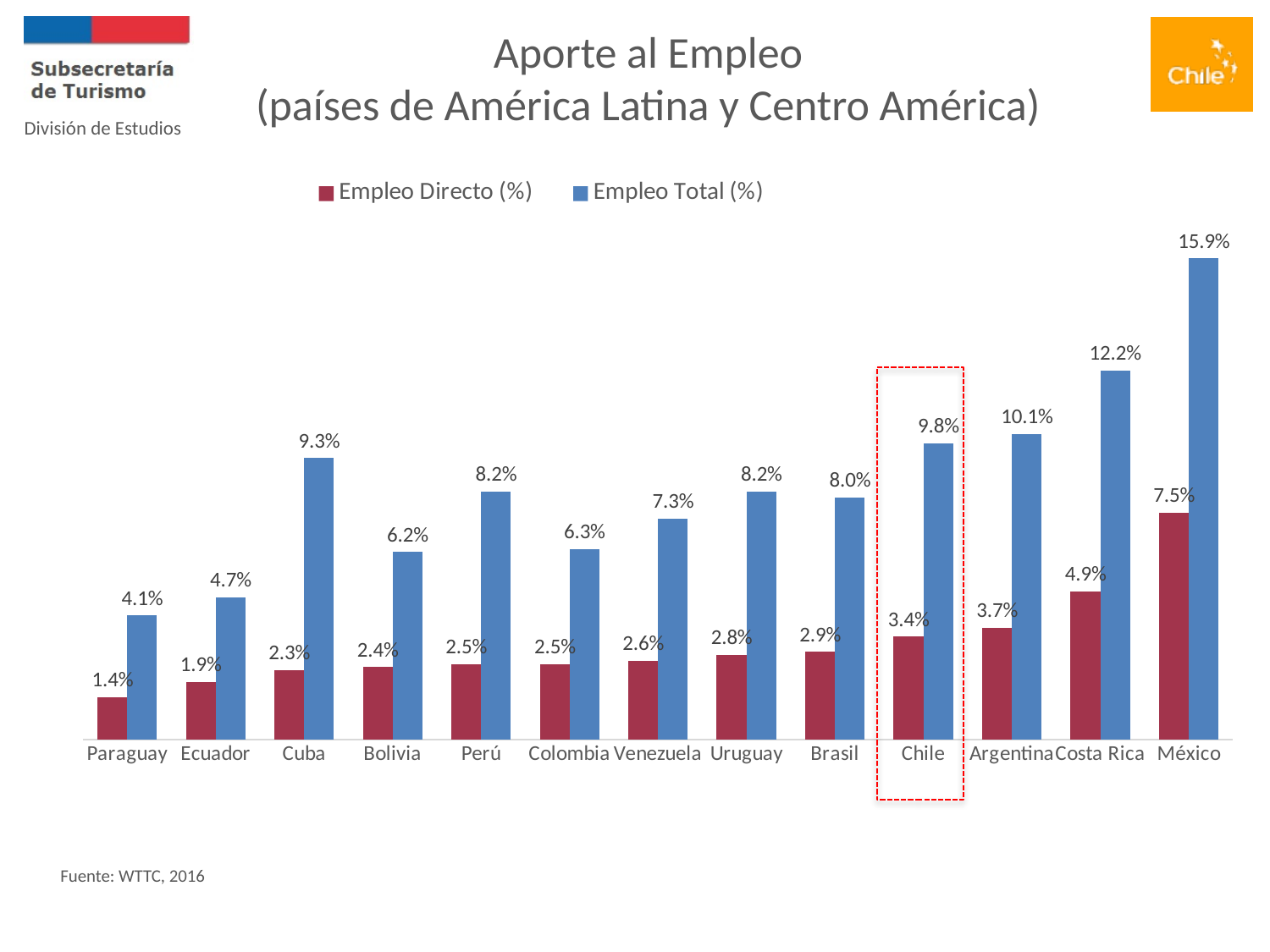
What kind of chart is shown on the slide? Bar chart What is the difference between the Empleo Total (%) and Empleo Directo (%) values for México? 8.4% Which country is highlighted with a red dashed box on the chart? Chile Which country has the lowest Empleo Directo (%)? Paraguay What is the Empleo Total (%) value for Chile? 9.8% Which is larger, the Empleo Total (%) for Cuba or for Brasil? Cuba What is the difference between the Empleo Total (%) values for Argentina and Chile? 0.3% Which country has the highest Empleo Total (%)? México How many series does the legend list? 2 Do the Empleo Directo (%) values generally rise or fall from Paraguay to México? Rise What is the Empleo Directo (%) value for Costa Rica? 4.9% How many countries are shown on the x axis? 13